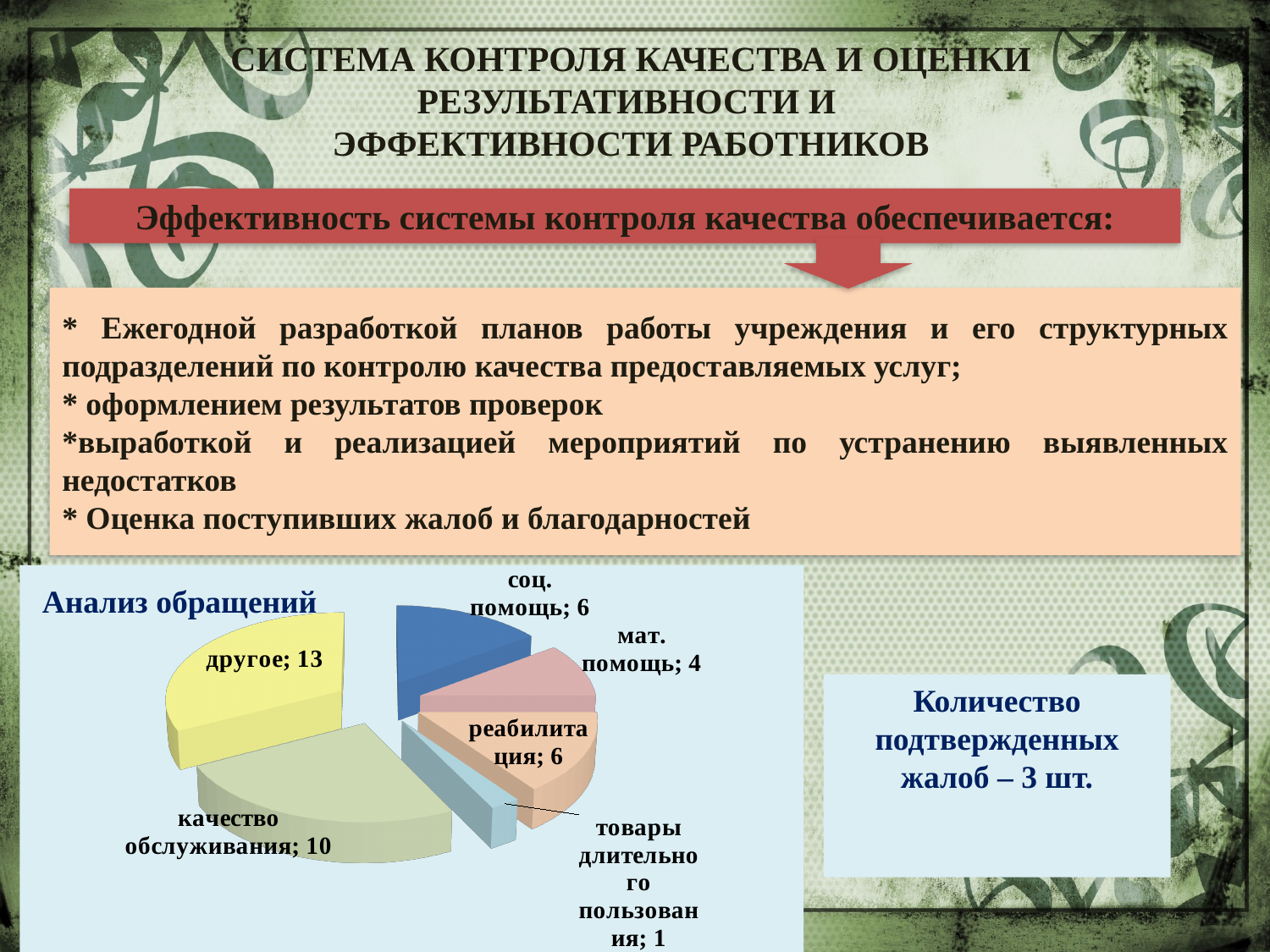
What type of chart is shown under the heading "Анализ обращений"? Pie chart How many categories are shown in the "Анализ обращений" pie chart? 6 Which category has the smallest slice in the "Анализ обращений" pie chart? товары длительного пользования Which category has the largest slice in the "Анализ обращений" pie chart? другое In the "Анализ обращений" pie chart, what is the value for "товары длительного пользования"? 1 In the "Анализ обращений" pie chart, what is the value for "другое"? 13 In the "Анализ обращений" pie chart, what is the difference between "другое" and "качество обслуживания"? 3 In the "Анализ обращений" pie chart, which is larger: "соц. помощь" or "мат. помощь"? соц. помощь In the "Анализ обращений" pie chart, what is the value for "качество обслуживания"? 10 What is the title of the pie chart on the slide? Анализ обращений What share of the "Анализ обращений" pie does "качество обслуживания" represent? 25% In the "Анализ обращений" pie chart, what is the value for "мат. помощь"? 4